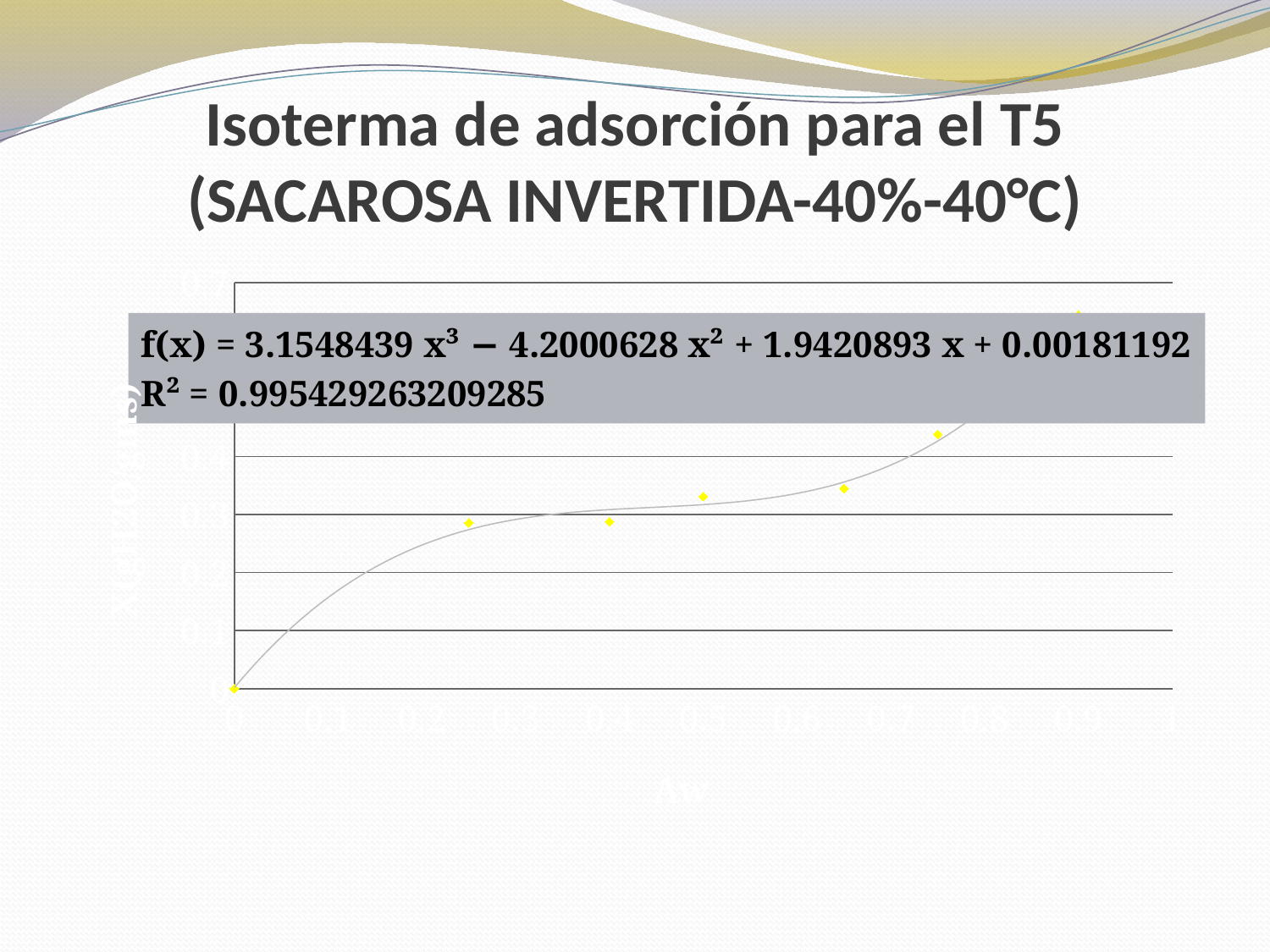
What is the R² value shown on the chart? 0.995429263209285 How many data points are plotted on the chart? 7 What is the fitted equation shown on the chart? f(x) = 3.1548439 x³ – 4.2000628 x² + 1.9420893 x + 0.00181192 Is the value of the data point at Aw ≈ 0.5 greater or less than 0.3? greater What is the label of the x axis? Aw Is the value of the data point at Aw ≈ 0.9 greater or less than 0.6? greater Is the value of the data point at Aw ≈ 0.75 greater or less than 0.4? greater What kind of chart is shown on the slide? scatter chart Which data point has the highest value on the chart? the point at Aw ≈ 0.9 What is the title of the chart? Isoterma de adsorción para el T5 (SACAROSA INVERTIDA-40%-40°C) Do the plotted values generally rise or fall as Aw increases along the x axis? rise